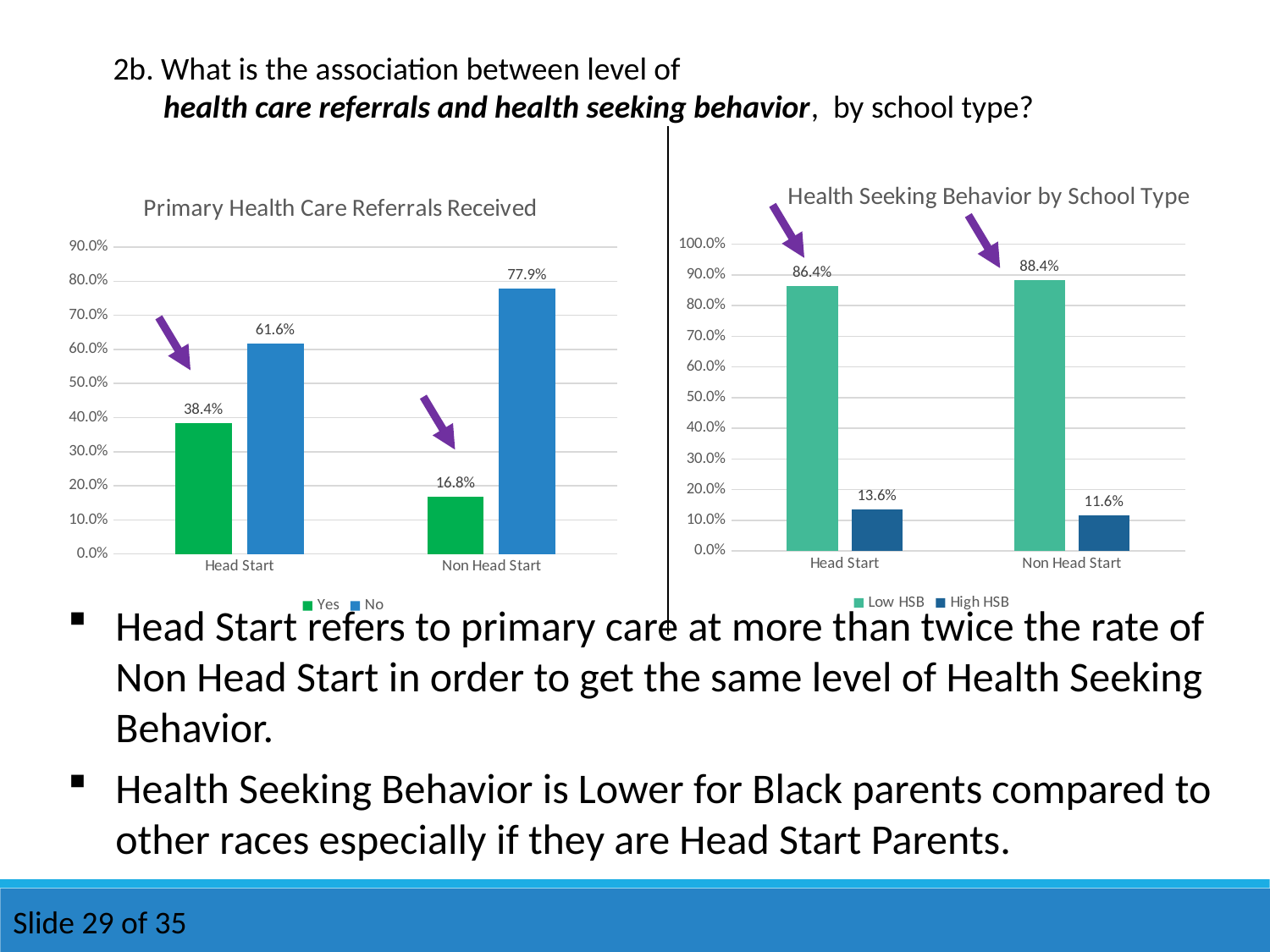
In the 'Health Seeking Behavior by School Type' chart, what is the value for High HSB for Head Start? 13.6% In the 'Primary Health Care Referrals Received' chart, which category has the higher Yes value, Head Start or Non Head Start? Head Start In the 'Health Seeking Behavior by School Type' chart, what is the difference between the Low HSB values for Non Head Start and Head Start? 2.0% In the 'Primary Health Care Referrals Received' chart, what is the value for Yes for Head Start? 38.4% In the 'Primary Health Care Referrals Received' chart, what is the difference between the Yes values for Head Start and Non Head Start? 21.6% In the 'Primary Health Care Referrals Received' chart, how many series does the legend list? 2 In the 'Health Seeking Behavior by School Type' chart, what are the two legend entries? Low HSB and High HSB In the 'Health Seeking Behavior by School Type' chart, which bar is the lowest? High HSB for Non Head Start In the 'Primary Health Care Referrals Received' chart, what is the value for No for Non Head Start? 77.9% In the 'Health Seeking Behavior by School Type' chart, how many categories are shown on the x axis? 2 What kind of chart is the 'Health Seeking Behavior by School Type' chart? Bar chart In the 'Health Seeking Behavior by School Type' chart, what is the value for Low HSB for Non Head Start? 88.4%